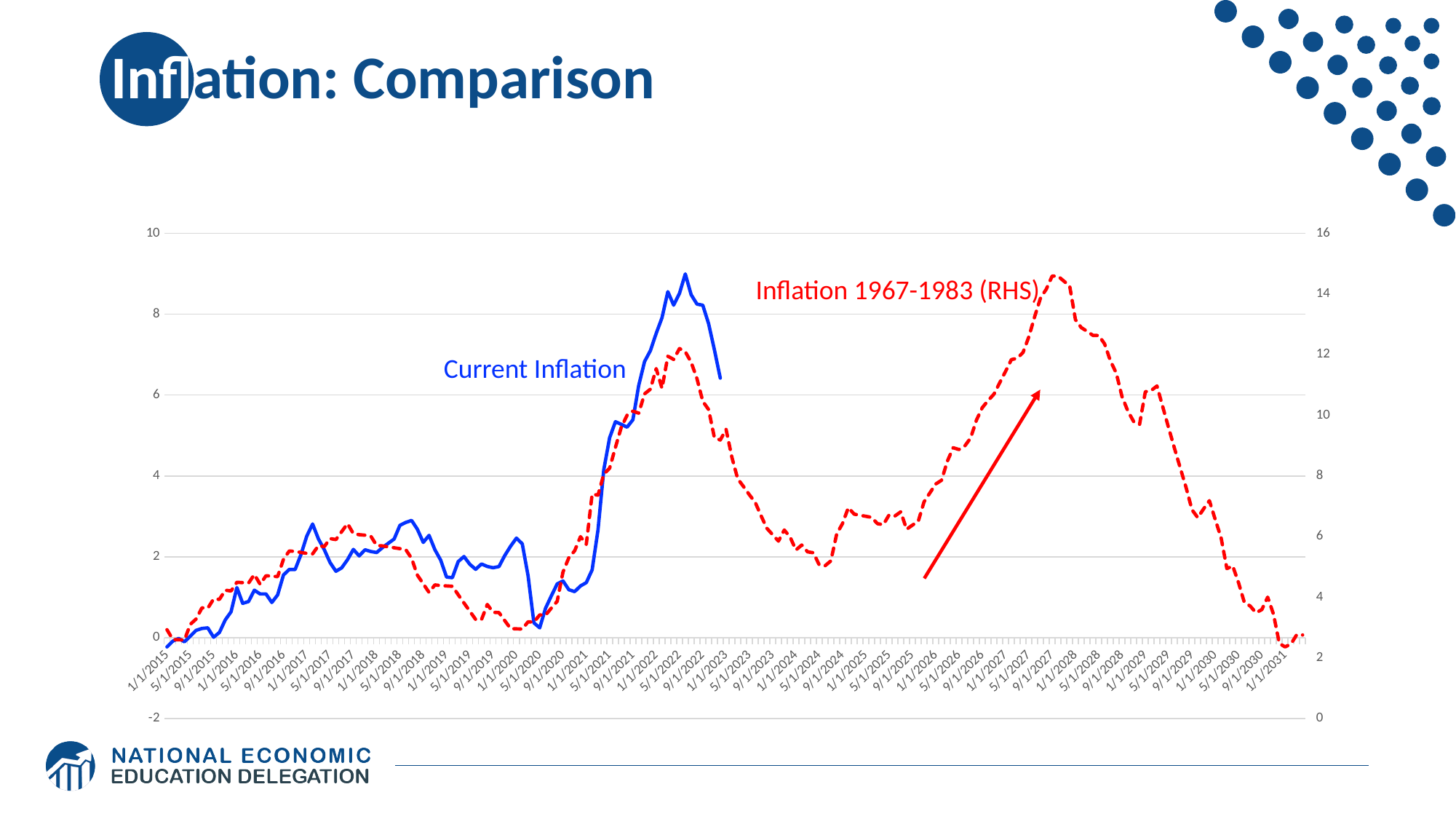
How many data series are plotted on the chart? 2 Does the 'Inflation 1967-1983 (RHS)' series rise or fall between 9/1/2027 and 1/1/2031? Fall What is the highest tick value shown on the right vertical axis? 16 Which axis does the 'Inflation 1967-1983' series use? Right-hand side (RHS) What colour is the 'Current Inflation' line? Blue Does the 'Current Inflation' series rise or fall between 1/1/2021 and 5/1/2022? Rise What kind of chart is shown on the slide? Line chart Is the peak value of the 'Current Inflation' series greater or less than 8 on the left axis? greater Is the value of the 'Current Inflation' series at 5/1/2020 greater or less than 2 on the left axis? less Is the peak value of the 'Inflation 1967-1983 (RHS)' series greater or less than 12 on the right axis? greater What is the highest tick value shown on the left vertical axis? 10